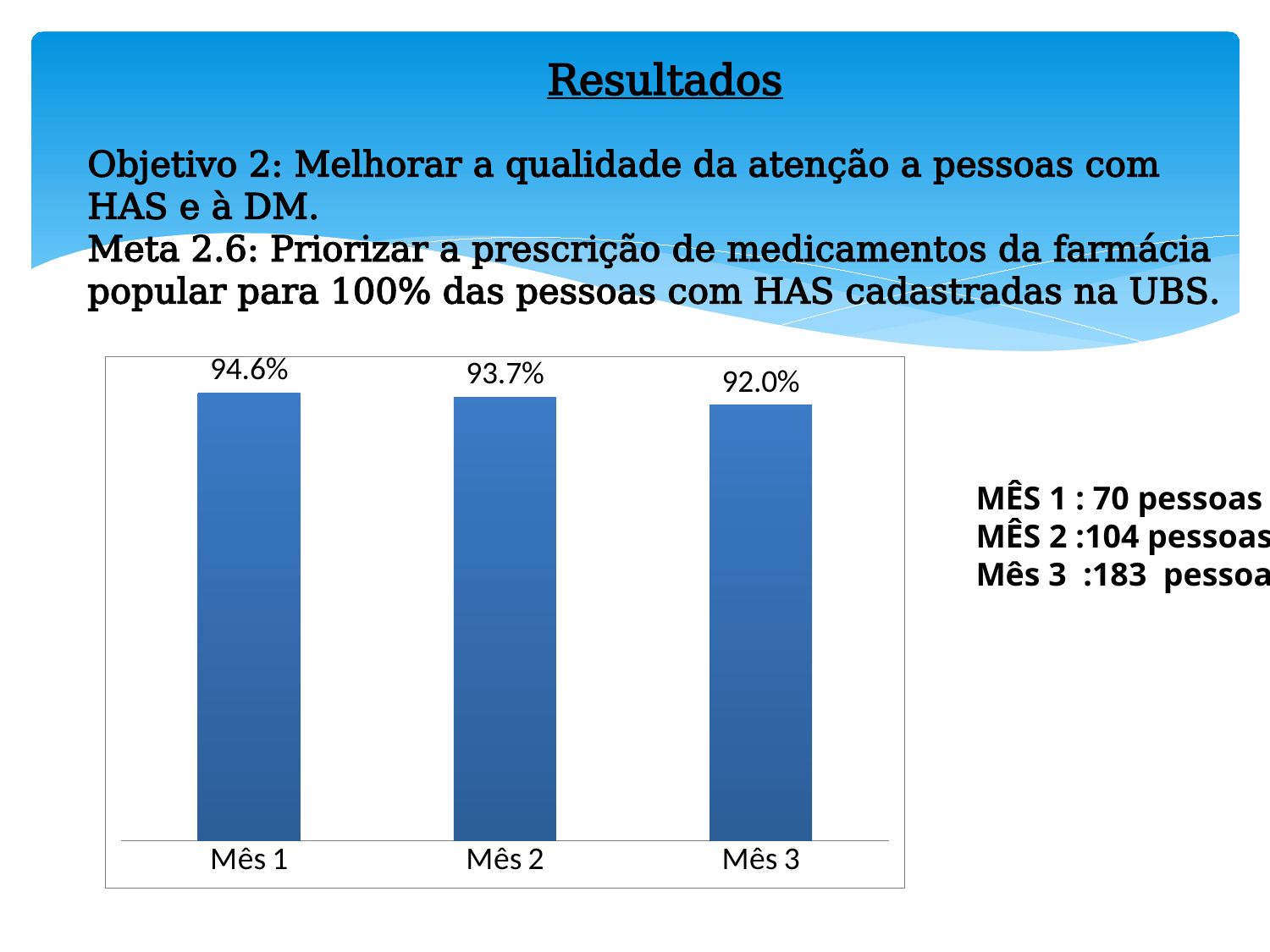
What is the difference between the values for Mês 1 and Mês 2? 0.9% How many months are shown in the chart? 3 What is the value for Mês 2? 93.7% Which month has the highest value? Mês 1 Which month has the lowest value? Mês 3 Which is larger, the value for Mês 2 or the value for Mês 3? Mês 2 Do the values rise or fall from Mês 1 to Mês 3? Fall What is the value for Mês 3? 92.0% What colour are the bars in the chart? Blue What kind of chart is shown on the slide? Bar chart What is the value for Mês 1? 94.6% What is the difference between the values for Mês 1 and Mês 3? 2.6%